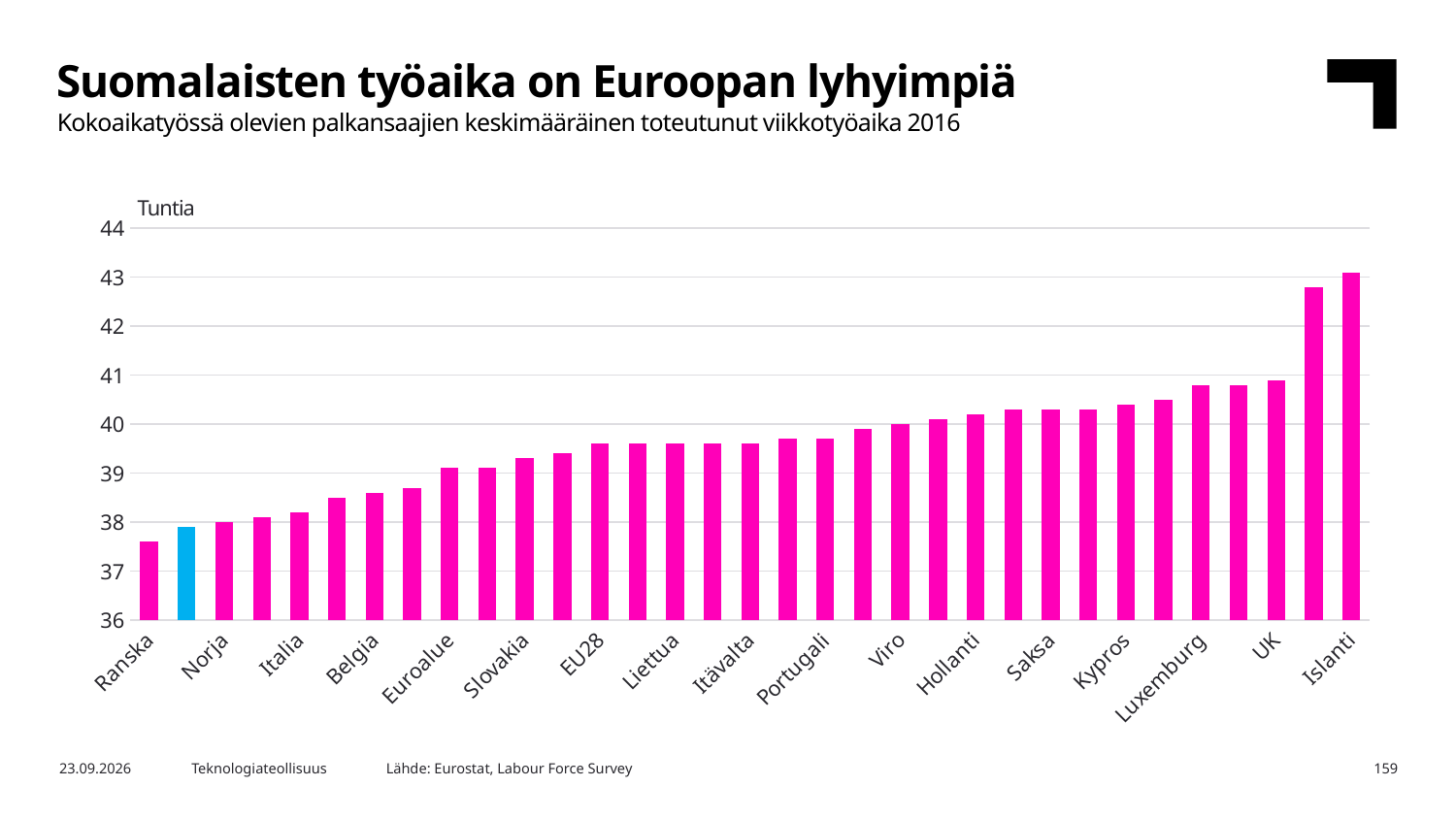
Is the value for Saksa greater or less than 40? greater Which is larger, the value for Luxemburg or the value for Belgia? Luxemburg What unit is shown at the top of the vertical axis? Tuntia How many bars are plotted in the chart? 33 Is the value for Islanti greater or less than 42? greater Do the values rise or fall from left to right along the x axis? rise Which category has the lowest value in the chart? Ranska Which category has the highest value in the chart? Islanti Is the value for Belgia greater or less than 39? less What kind of chart is shown on the slide? bar chart